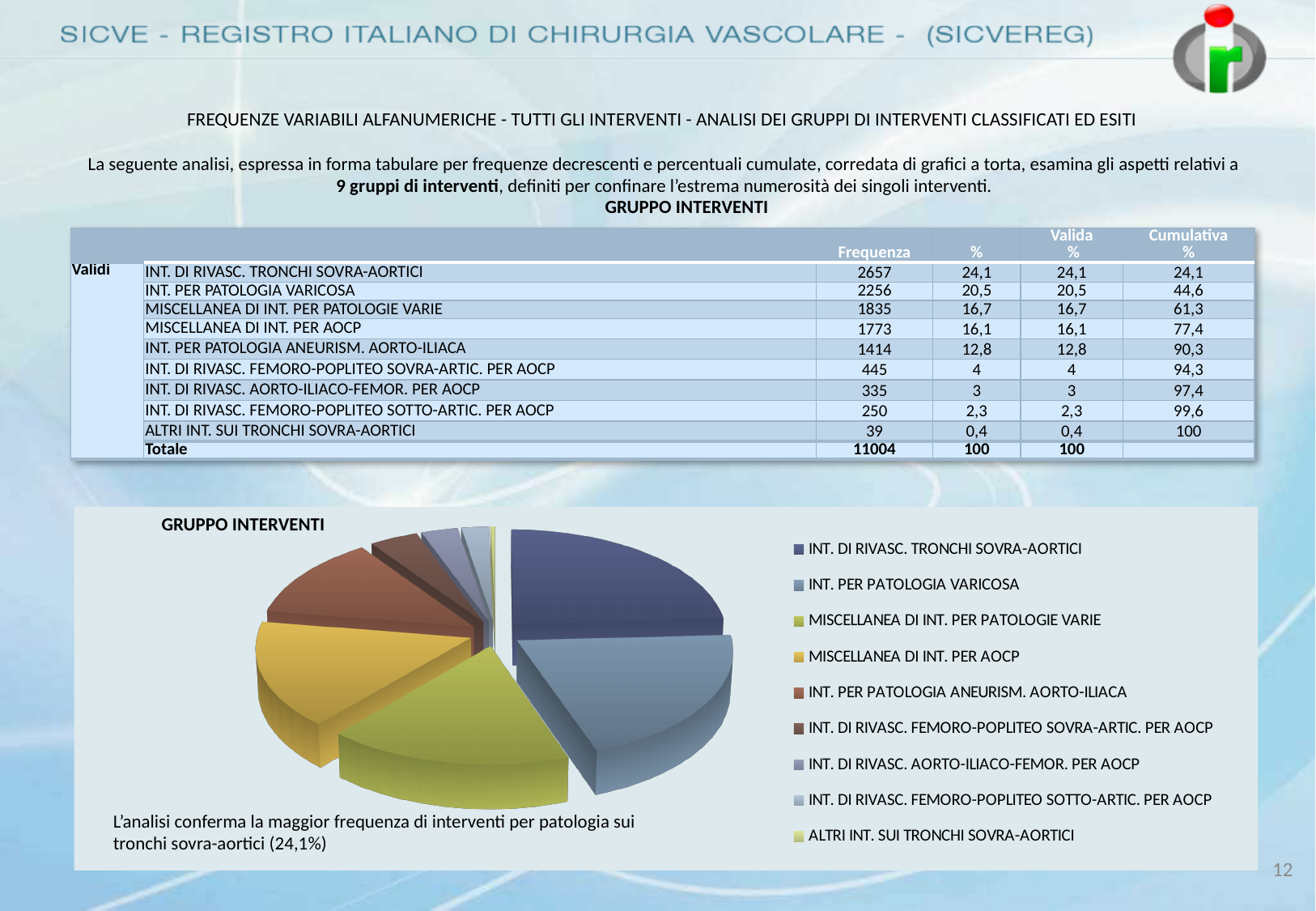
According to the slide, what share of the pie does MISCELLANEA DI INT. PER PATOLOGIE VARIE represent? 16,7% According to the slide, what share of the pie does ALTRI INT. SUI TRONCHI SOVRA-AORTICI represent? 0,4% What is the title of the pie chart? GRUPPO INTERVENTI According to the slide, what share of the pie does INT. DI RIVASC. TRONCHI SOVRA-AORTICI represent? 24,1% Which slice is larger in the pie chart: INT. PER PATOLOGIA VARICOSA or INT. PER PATOLOGIA ANEURISM. AORTO-ILIACA? INT. PER PATOLOGIA VARICOSA Which category has the largest slice in the pie chart? INT. DI RIVASC. TRONCHI SOVRA-AORTICI Which legend entry is listed first in the pie chart's legend? INT. DI RIVASC. TRONCHI SOVRA-AORTICI Which category has the smallest slice in the pie chart? ALTRI INT. SUI TRONCHI SOVRA-AORTICI Which slice is larger in the pie chart: INT. DI RIVASC. FEMORO-POPLITEO SOVRA-ARTIC. PER AOCP or MISCELLANEA DI INT. PER AOCP? MISCELLANEA DI INT. PER AOCP How many entries does the pie chart's legend list? 9 What kind of chart is shown on the slide? pie chart How many slices does the pie chart have? 9